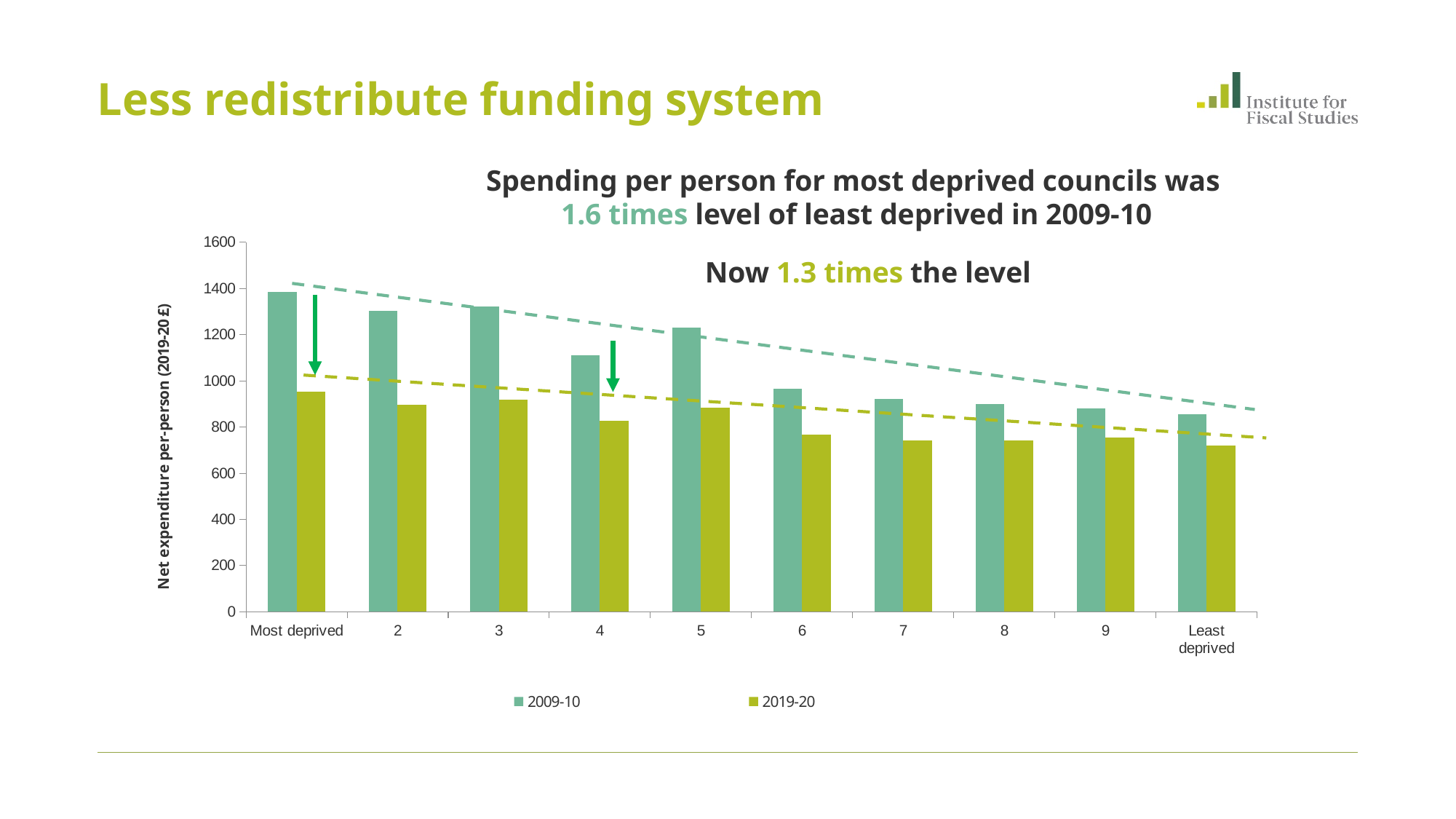
Do the 2009-10 values generally rise or fall moving from Most deprived to Least deprived? Fall Is the 2019-20 value for Most deprived greater or less than 1000? less Is the 2009-10 value for Most deprived greater or less than 1200? greater What is the label on the vertical axis? Net expenditure per-person (2019-20 £) Which category has the highest 2019-20 value? Most deprived Which category has the highest 2009-10 value? Most deprived What kind of chart is shown on the slide? Bar chart For the Most deprived category, which series has the larger value, 2009-10 or 2019-20? 2009-10 Is the 2009-10 value for category 6 greater or less than 1000? less How many series does the legend list? 2 How many deprivation categories are shown on the x axis? 10